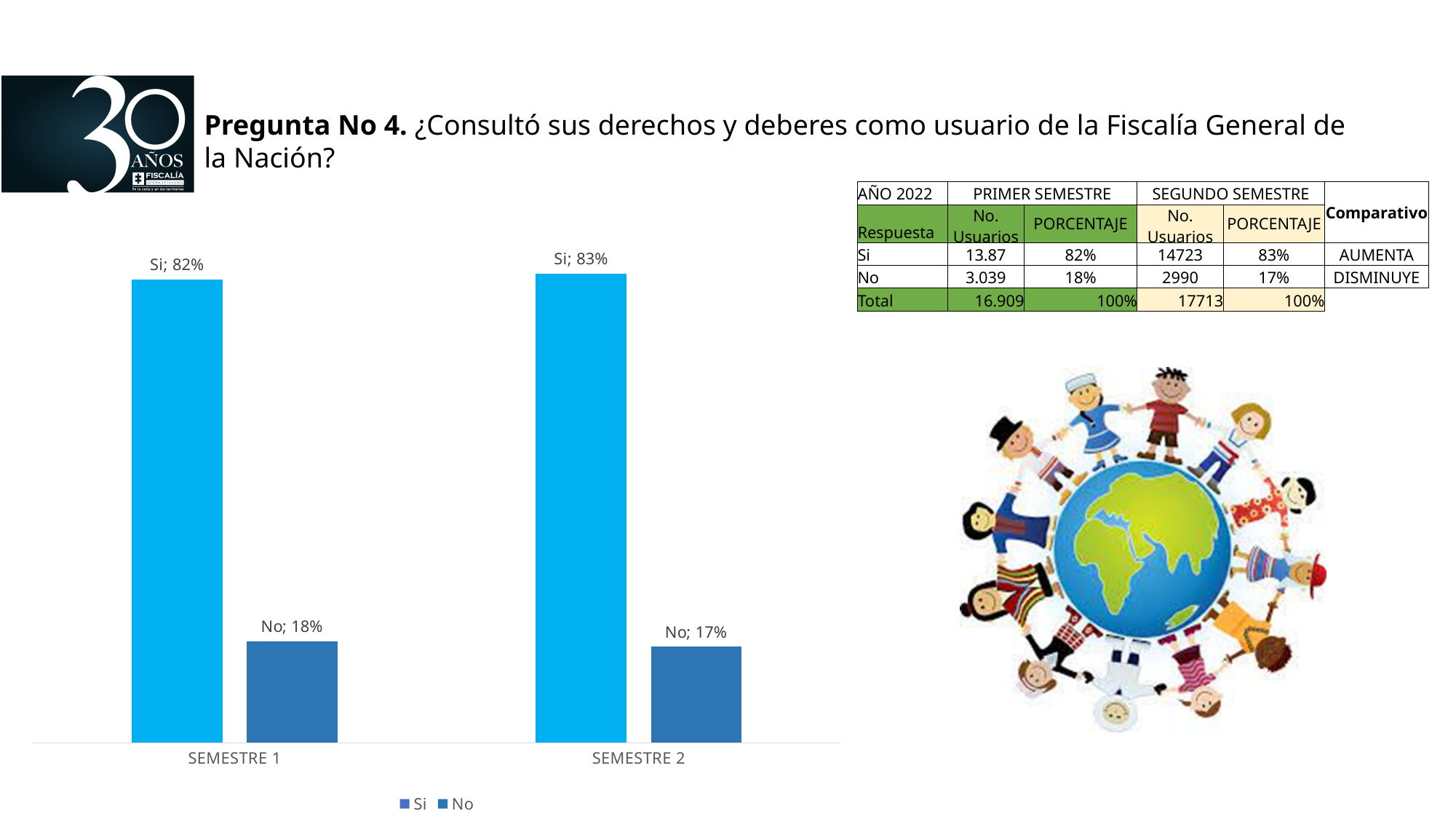
Which is larger: Si in SEMESTRE 1 or No in SEMESTRE 1? Si in SEMESTRE 1 What kind of chart is shown on the slide? bar chart How many series does the chart legend list? 2 Which bar in the chart has the lowest value? No in SEMESTRE 2 What is the difference between the Si and No values in SEMESTRE 1? 64% What are the two series names listed in the chart legend? Si and No What is the value for Si in SEMESTRE 2? 83% What is the value for No in SEMESTRE 1? 18% What is the value for Si in SEMESTRE 1? 82% How many categories are shown on the x axis of the chart? 2 Which bar in the chart has the highest value? Si in SEMESTRE 2 What is the value for No in SEMESTRE 2? 17%